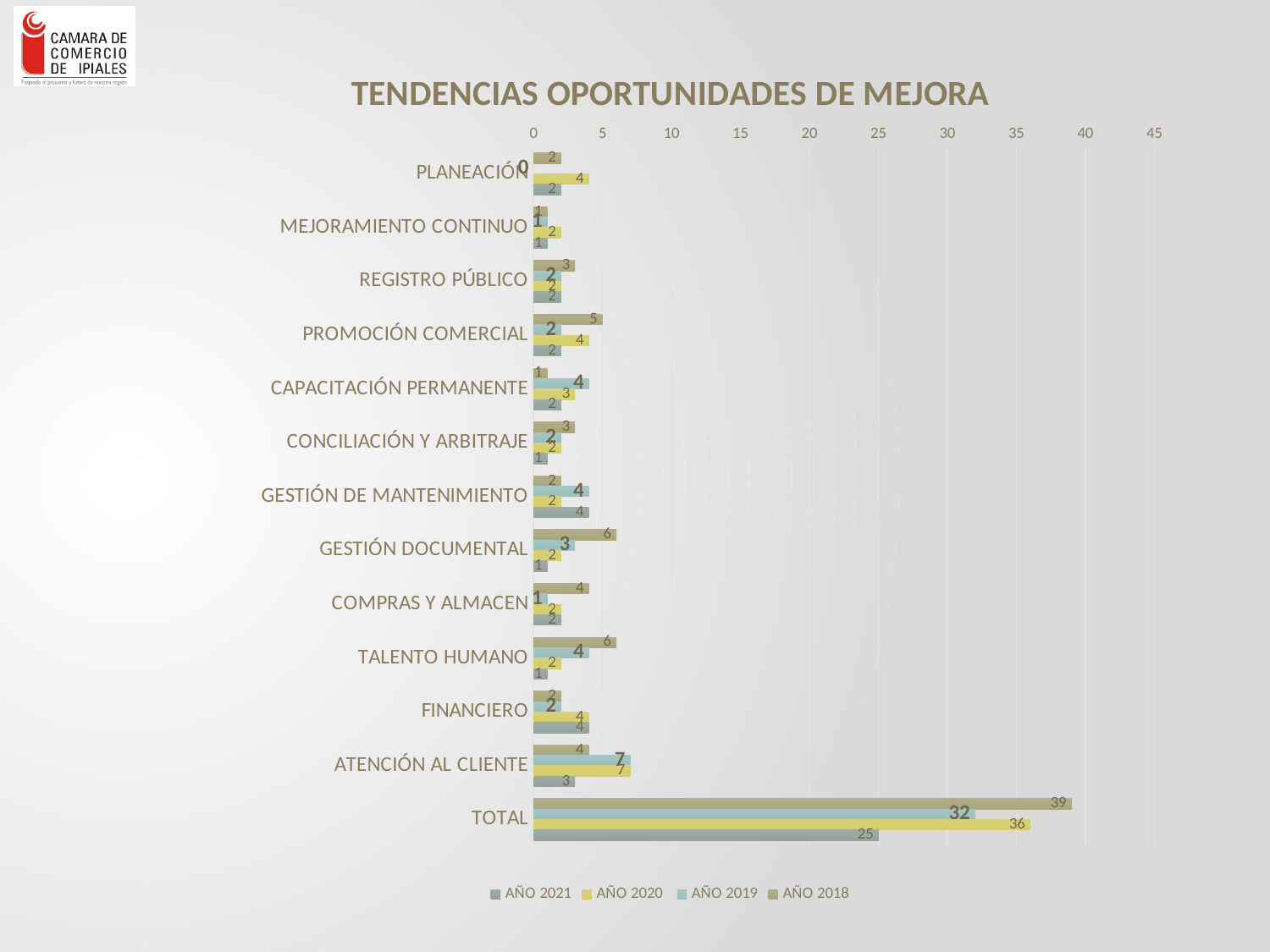
What is the value for TALENTO HUMANO in the AÑO 2018 series? 6 Which is larger for GESTIÓN DOCUMENTAL: the AÑO 2018 value or the AÑO 2021 value? AÑO 2018 How many series does the legend list? 4 Is the TOTAL value for AÑO 2019 greater or less than 30? greater Which year has the highest TOTAL value? AÑO 2018 Which year has the lowest TOTAL value? AÑO 2021 What is the value for TOTAL in the AÑO 2021 series? 25 What is the title of the chart? TENDENCIAS OPORTUNIDADES DE MEJORA What is the value for TOTAL in the AÑO 2018 series? 39 What is the value for ATENCIÓN AL CLIENTE in the AÑO 2019 series? 7 What kind of chart is shown on the slide? Bar chart What is the difference between the TOTAL values for AÑO 2020 and AÑO 2021? 11